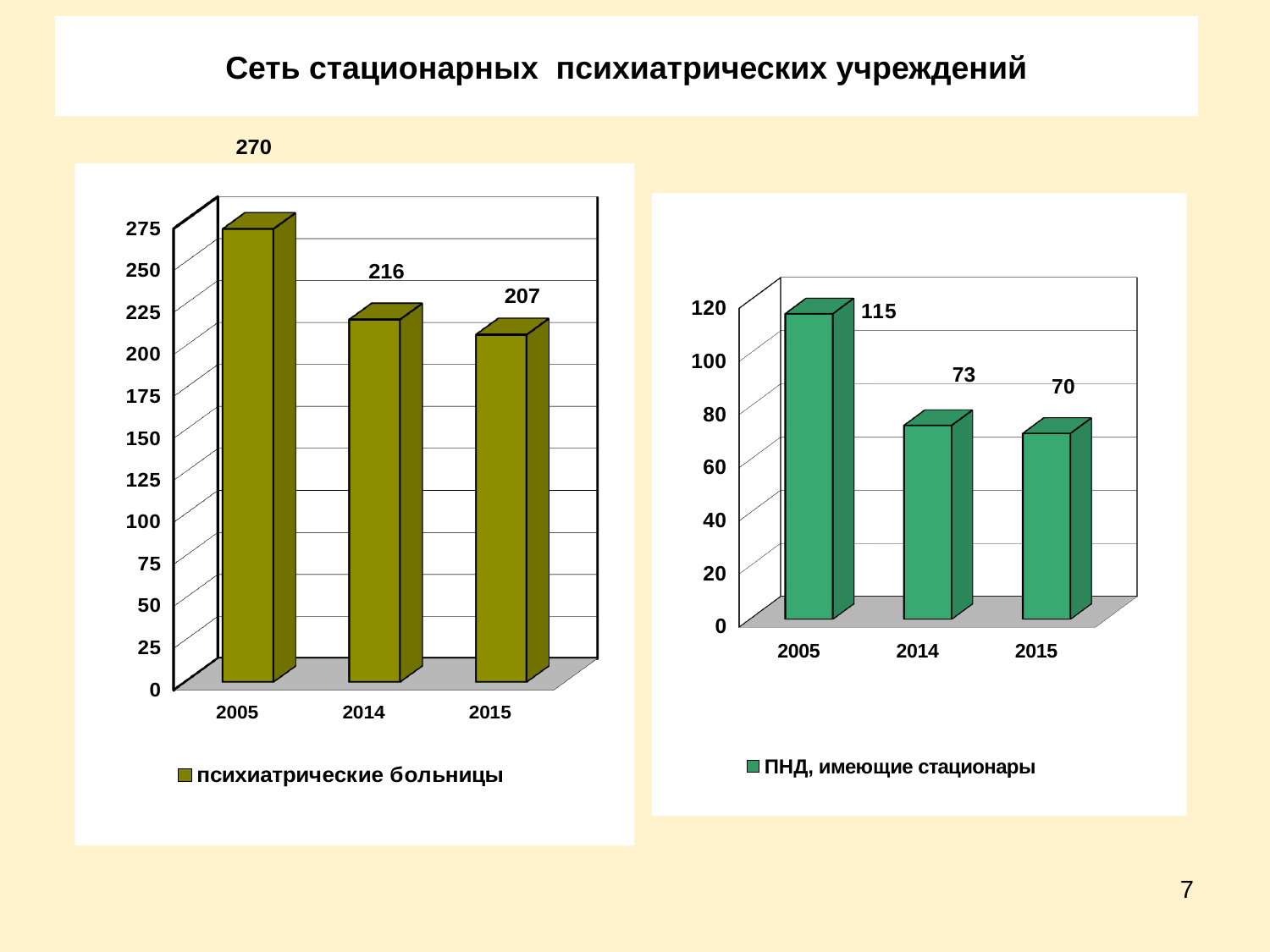
In the right chart (ПНД, имеющие стационары), what is the difference between the values for 2005 and 2015? 45 In the right chart (ПНД, имеющие стационары), which is larger: the value for 2014 or the value for 2015? 2014 In the right chart (ПНД, имеющие стационары), which year has the lowest value? 2015 In the left chart (психиатрические больницы), do the values rise or fall from 2005 to 2015? fall In the right chart (ПНД, имеющие стационары), what is the value for 2014? 73 In the left chart (психиатрические больницы), which year has the highest value? 2005 In the left chart (психиатрические больницы), what is the value for 2015? 207 What is the legend entry of the right chart? ПНД, имеющие стационары How many years are shown on the x axis of the left chart (психиатрические больницы)? 3 In the left chart (психиатрические больницы), what is the value for 2005? 270 What kind of chart is the right chart (ПНД, имеющие стационары)? bar chart In the left chart (психиатрические больницы), what is the difference between the values for 2005 and 2014? 54